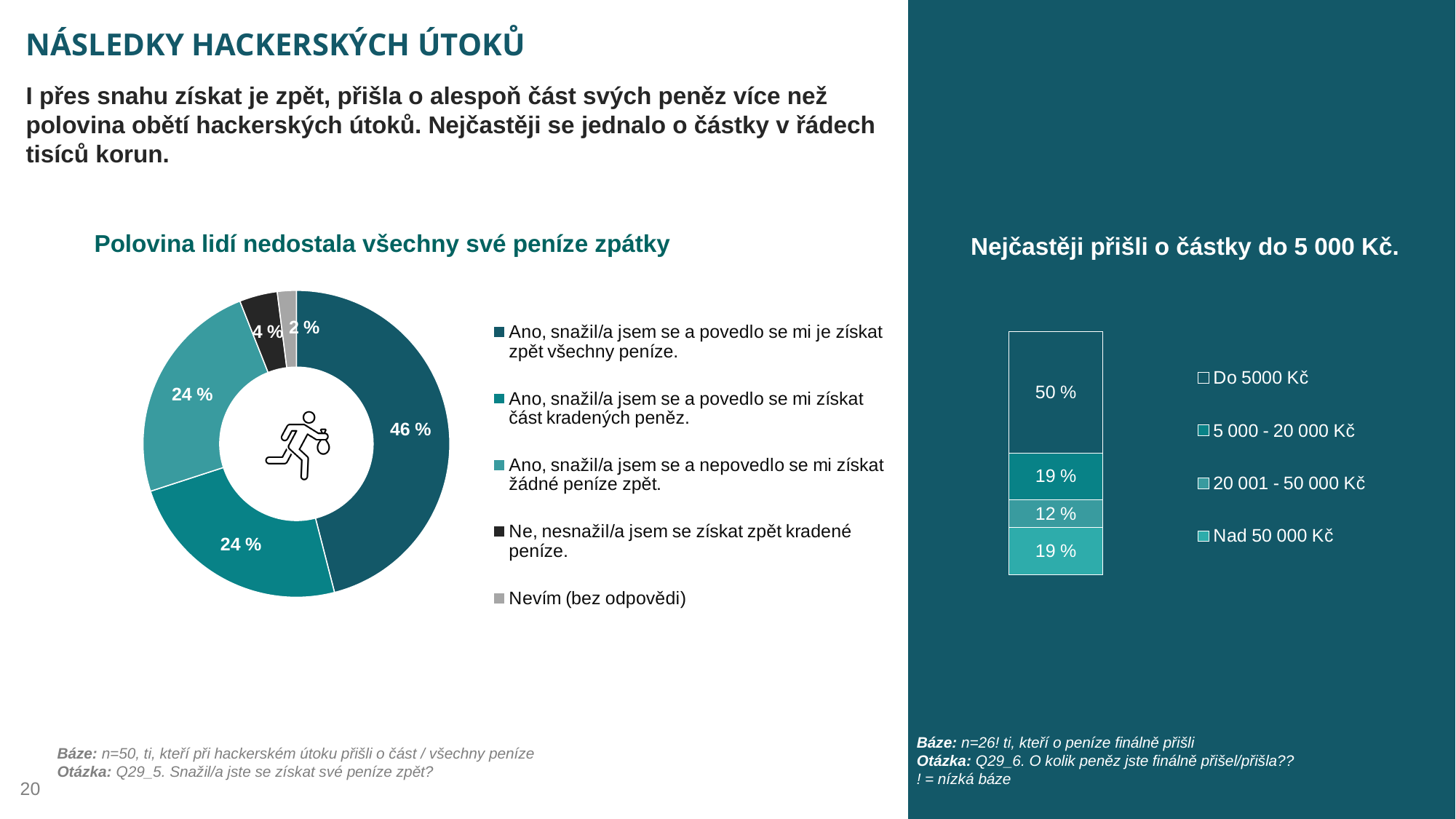
What kind of chart is the left chart 'Polovina lidí nedostala všechny své peníze zpátky'? Donut (pie) chart In the right chart 'Nejčastěji přišli o částky do 5 000 Kč.', how many segments does the legend list? 4 In the right chart 'Nejčastěji přišli o částky do 5 000 Kč.', what is the value for '20 001 - 50 000 Kč'? 12 % In the left chart 'Polovina lidí nedostala všechny své peníze zpátky', what share answered 'Ne, nesnažil/a jsem se získat zpět kradené peníze.'? 4 % In the left chart 'Polovina lidí nedostala všechny své peníze zpátky', which answer has the largest share? Ano, snažil/a jsem se a povedlo se mi je získat zpět všechny peníze. In the right chart 'Nejčastěji přišli o částky do 5 000 Kč.', what is the value for 'Do 5000 Kč'? 50 % In the right chart 'Nejčastěji přišli o částky do 5 000 Kč.', what is the difference between the 'Do 5000 Kč' segment and the 'Nad 50 000 Kč' segment? 31 % In the left chart 'Polovina lidí nedostala všechny své peníze zpátky', what share answered 'Nevím (bez odpovědi)'? 2 % In the left chart 'Polovina lidí nedostala všechny své peníze zpátky', how many categories does the legend list? 5 In the left chart 'Polovina lidí nedostala všechny své peníze zpátky', what share of respondents said they tried and got all their money back ('Ano, snažil/a jsem se a povedlo se mi je získat zpět všechny peníze.')? 46 % In the right chart 'Nejčastěji přišli o částky do 5 000 Kč.', what is the total of all segments of the stacked bar? 100 % In the left chart 'Polovina lidí nedostala všechny své peníze zpátky', which answer has the smallest share? Nevím (bez odpovědi)